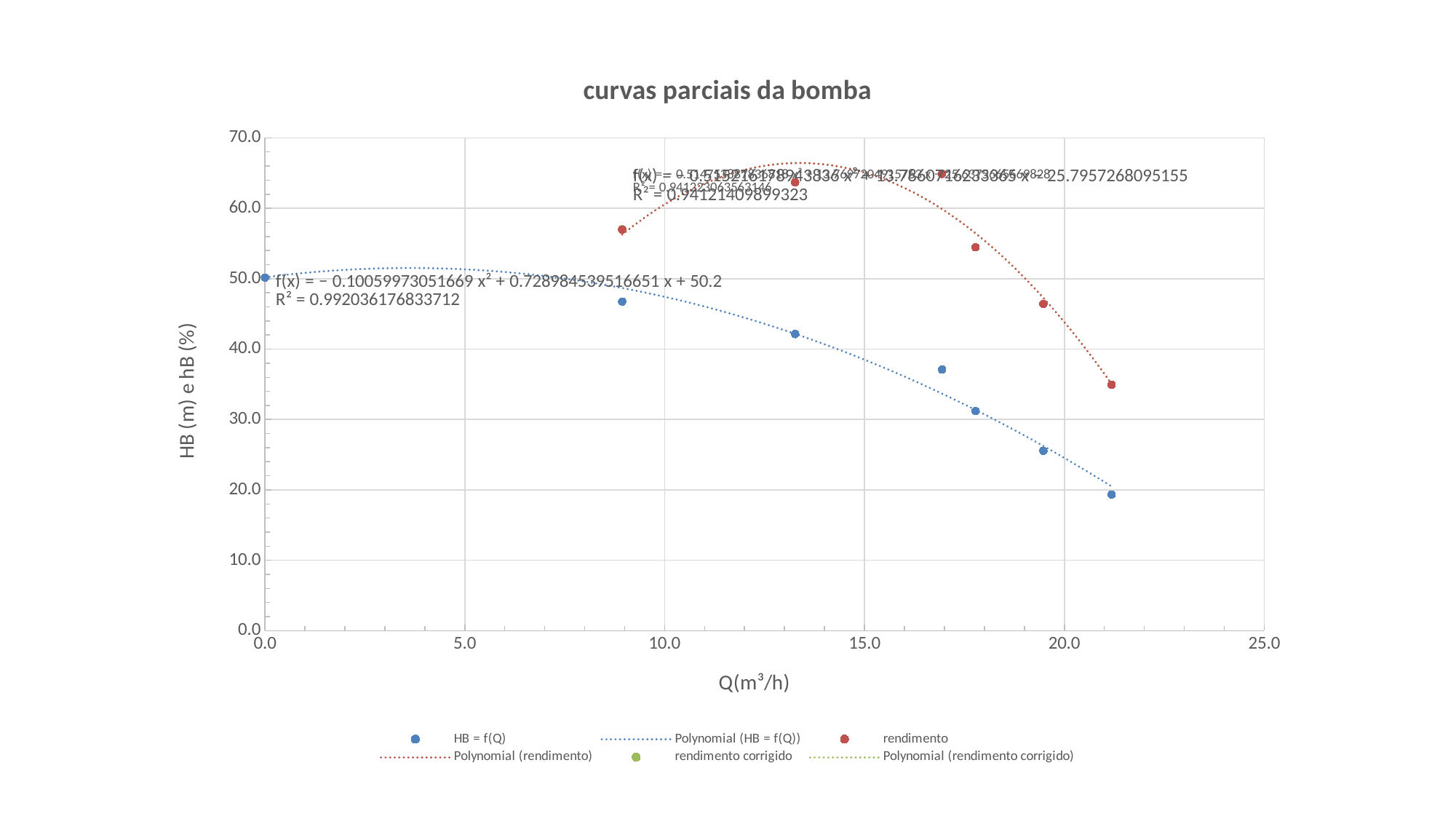
How many data points are plotted for the rendimento series? 6 Is the HB = f(Q) value at Q of about 19.4 greater or less than 20? greater Is the rendimento value at Q of about 21.2 greater or less than 40? less Is the rendimento value at Q of about 9.0 greater or less than 50? greater How many data points are plotted for the HB = f(Q) series? 7 What type of chart is shown on the slide? scatter chart What is the R² value shown for the polynomial fit of HB = f(Q)? 0.992036176833712 What is the title of the chart? curvas parciais da bomba Does the HB = f(Q) series rise or fall as Q increases? fall At Q of about 17.7, which series has the larger value, HB = f(Q) or rendimento? rendimento How many entries does the chart legend list? 6